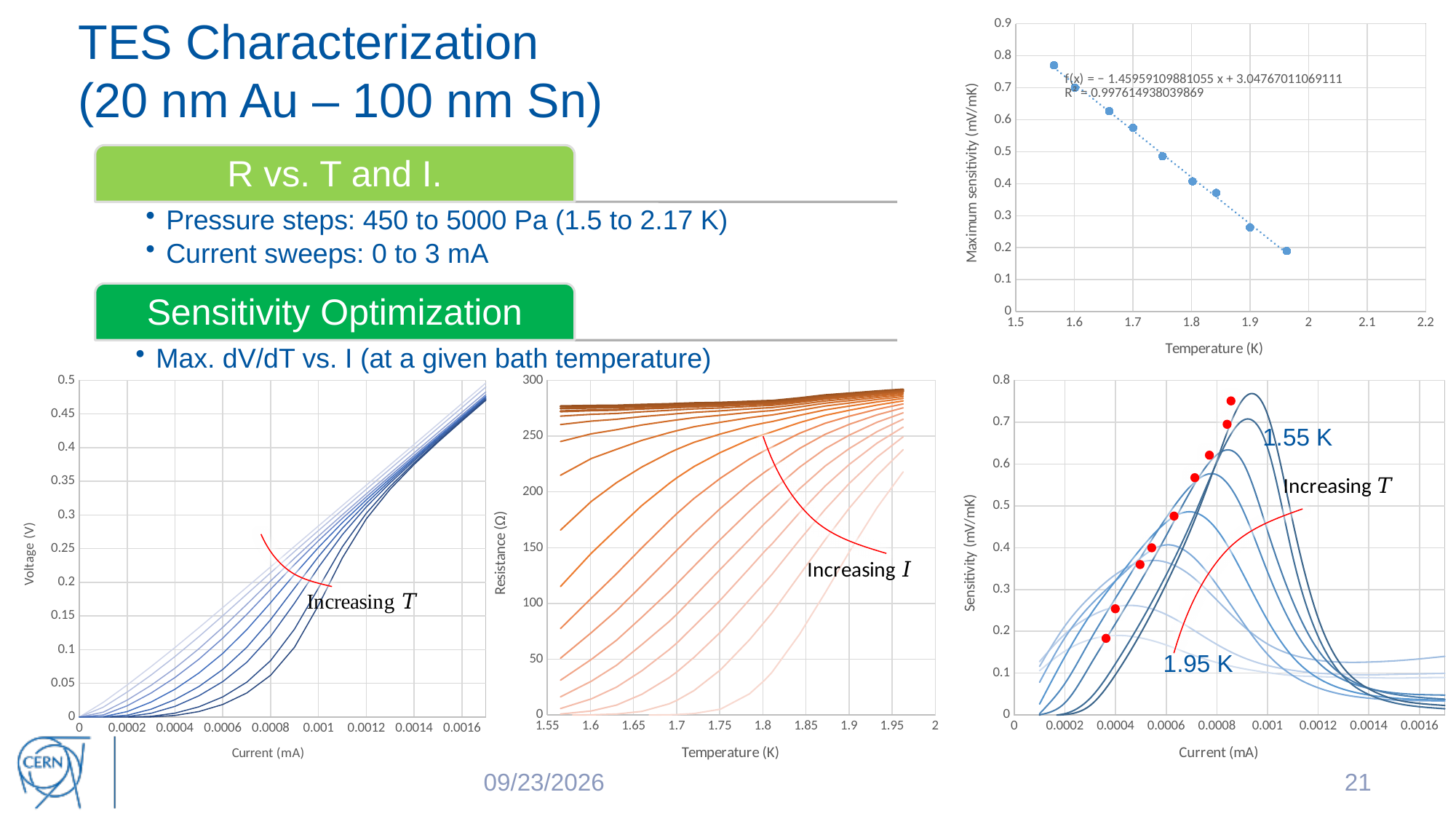
In the bottom-left chart, what quantity is plotted on the y axis? Voltage (V) What kind of chart is the top-right chart of maximum sensitivity versus temperature? scatter chart In the bottom-middle chart, what is the highest value shown on the resistance axis? 300 What R² value is printed on the top-right chart? 0.997614938039869 In the top-right chart, is the maximum sensitivity at 1.6 K greater or less than 0.6 mV/mK? greater In the top-right chart of maximum sensitivity versus temperature, how many data points are plotted? 9 In the bottom-right chart of sensitivity versus current, what are the two bath temperatures labelled on the curves? 1.55 K and 1.95 K What is the y-axis label of the top-right chart? Maximum sensitivity (mV/mK) In the top-right chart, which plotted point has the highest maximum sensitivity: the one at the lowest temperature or the one at the highest temperature? the one at the lowest temperature In the top-right chart, is the maximum sensitivity at 1.9 K greater or less than 0.3 mV/mK? less In the top-right chart, do the maximum sensitivity values rise or fall as temperature increases? fall In the bottom-left chart of voltage versus current, do the curves rise or fall as current increases? rise